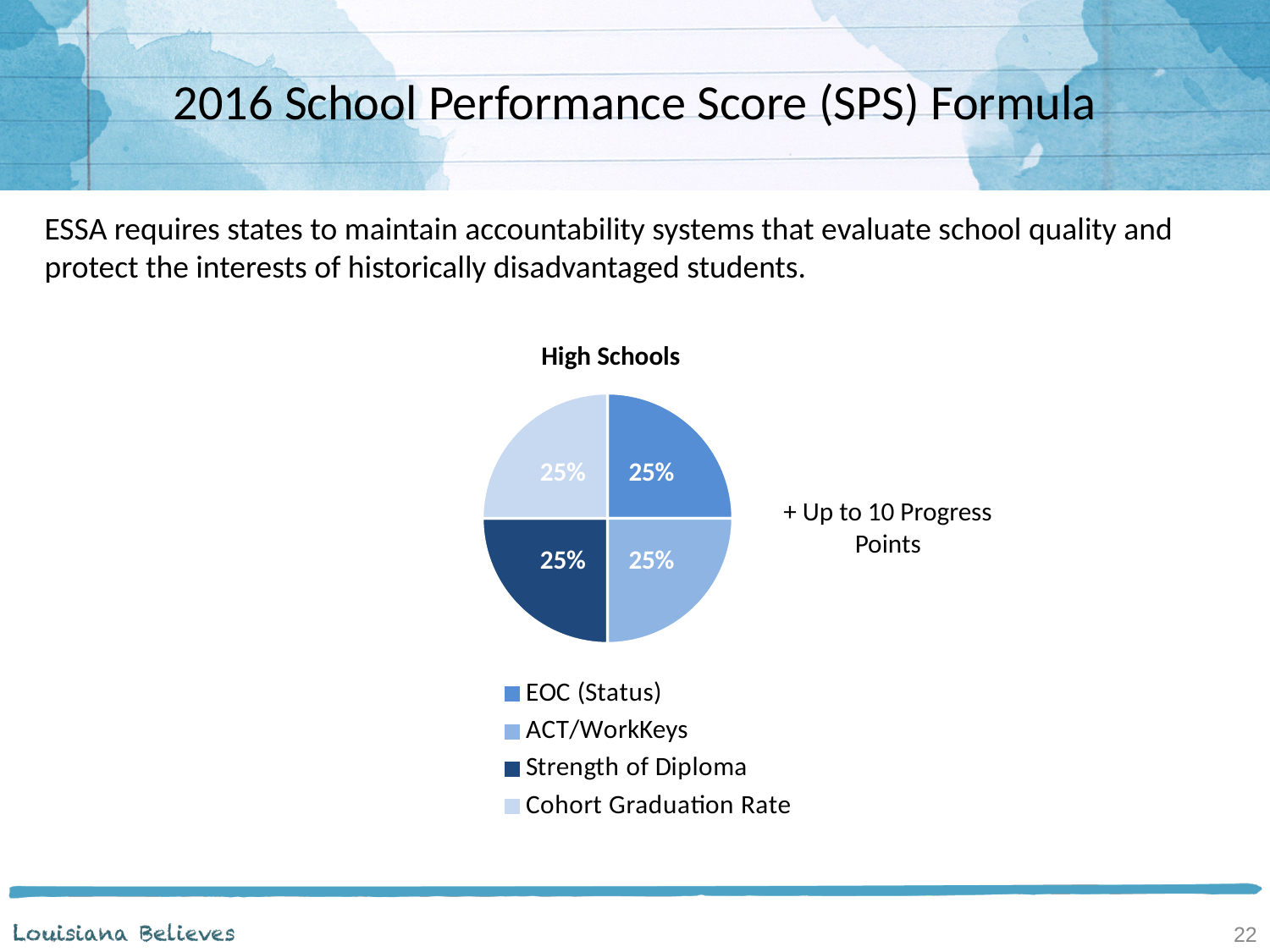
Is the share for Cohort Graduation Rate greater or less than 50%? less What share of the pie does ACT/WorkKeys represent? 25% What kind of chart is shown on the slide? pie chart How many entries does the legend list? 4 What is the title of the chart? High Schools What share of the pie does Cohort Graduation Rate represent? 25% What is the difference between the share for EOC (Status) and the share for Strength of Diploma? 0% What share of the pie does EOC (Status) represent? 25% What is the combined share of EOC (Status) and ACT/WorkKeys? 50% Which legend entry is shown in the darkest blue? Strength of Diploma How many slices does the pie chart have? 4